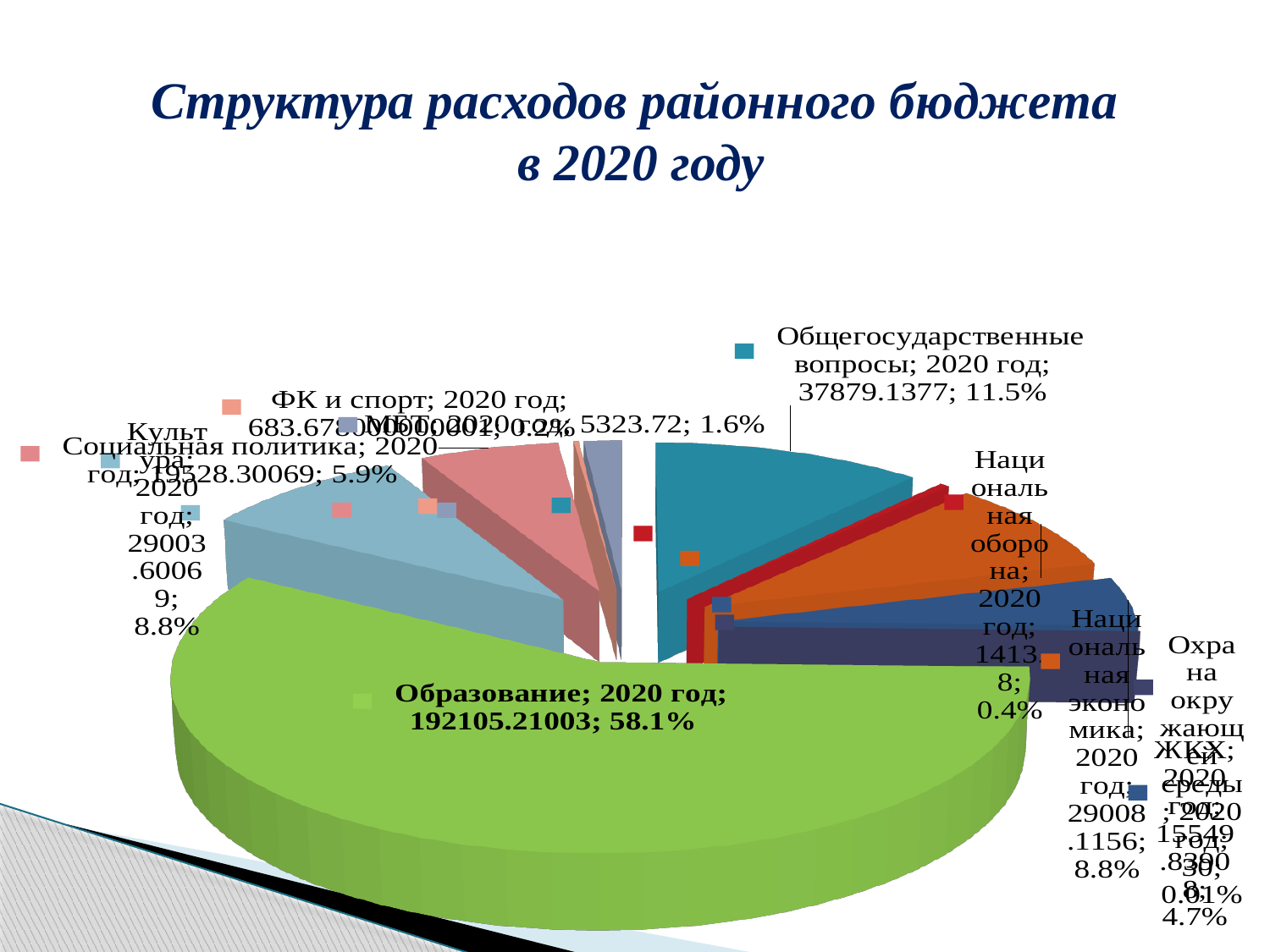
What share of the pie does Общегосударственные вопросы have? 11.5% What is the value shown for Образование? 192105.21003 What share of the pie does Национальная оборона have? 0.4% Which category has the largest share of the pie? Образование What share of the pie does Социальная политика have? 5.9% Which is larger, the share for Образование or the share for Общегосударственные вопросы? Образование What kind of chart is shown on the slide? pie chart What is the title of the chart? Структура расходов районного бюджета в 2020 году What is the difference in percentage points between the share for Образование and the share for Общегосударственные вопросы? 46.6% What is the value shown for Общегосударственные вопросы? 37879.1377